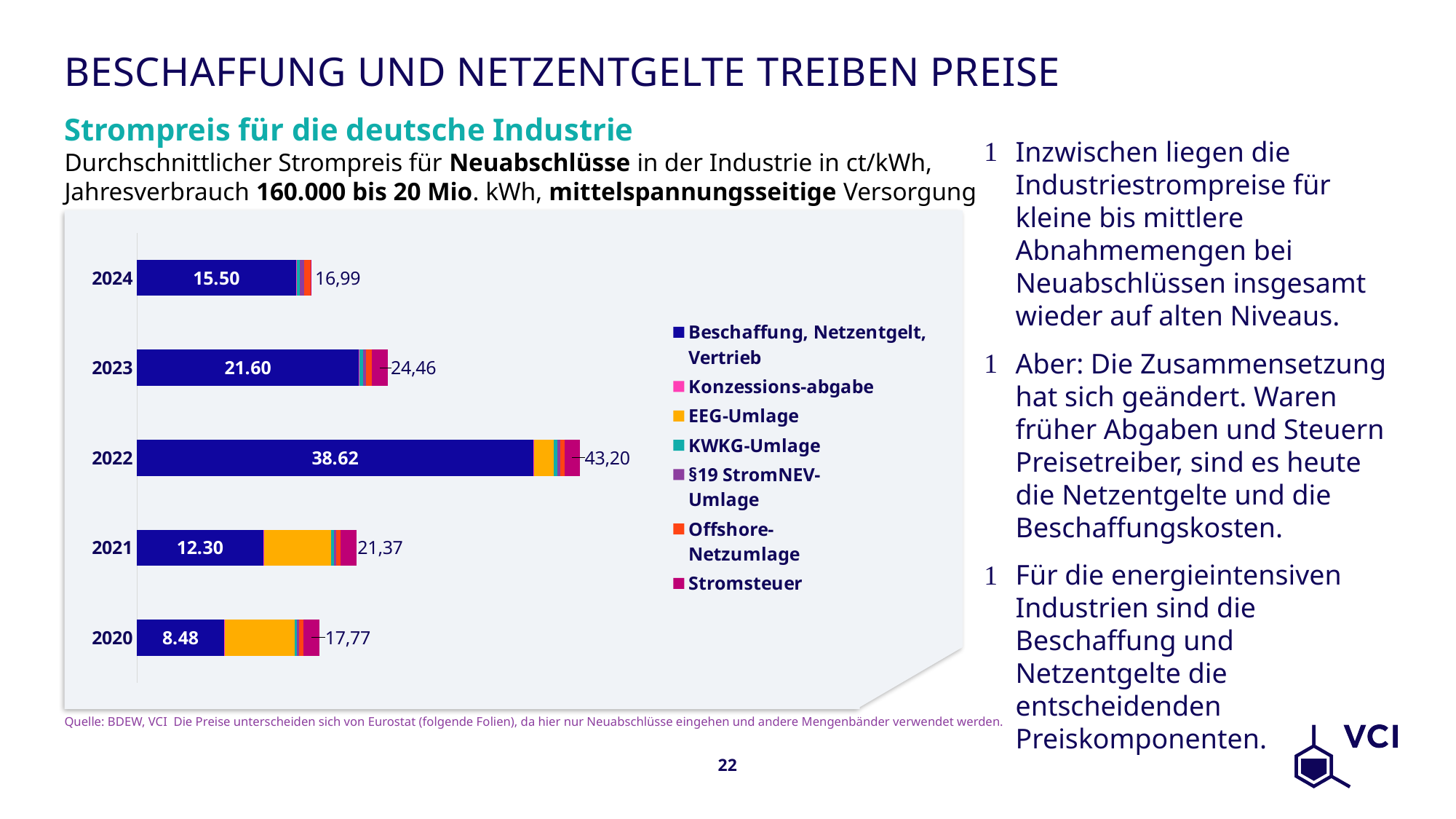
What type of chart is shown on the slide? stacked bar chart Which year has the lowest total electricity price? 2024 What is the total electricity price shown for 2023? 24,46 How many years are shown in the chart? 5 Which year has the larger Beschaffung, Netzentgelt, Vertrieb value, 2021 or 2024? 2024 How many series does the legend list? 7 What is the difference between the total price in 2022 and the total price in 2023? 18,74 Does the total electricity price rise or fall from 2022 to 2024? fall How much higher is the Beschaffung, Netzentgelt, Vertrieb value in 2022 than in 2023? 17.02 What is the value of the Beschaffung, Netzentgelt, Vertrieb segment for 2022? 38.62 What is the value of the Beschaffung, Netzentgelt, Vertrieb segment for 2020? 8.48 Which year has the highest total electricity price? 2022